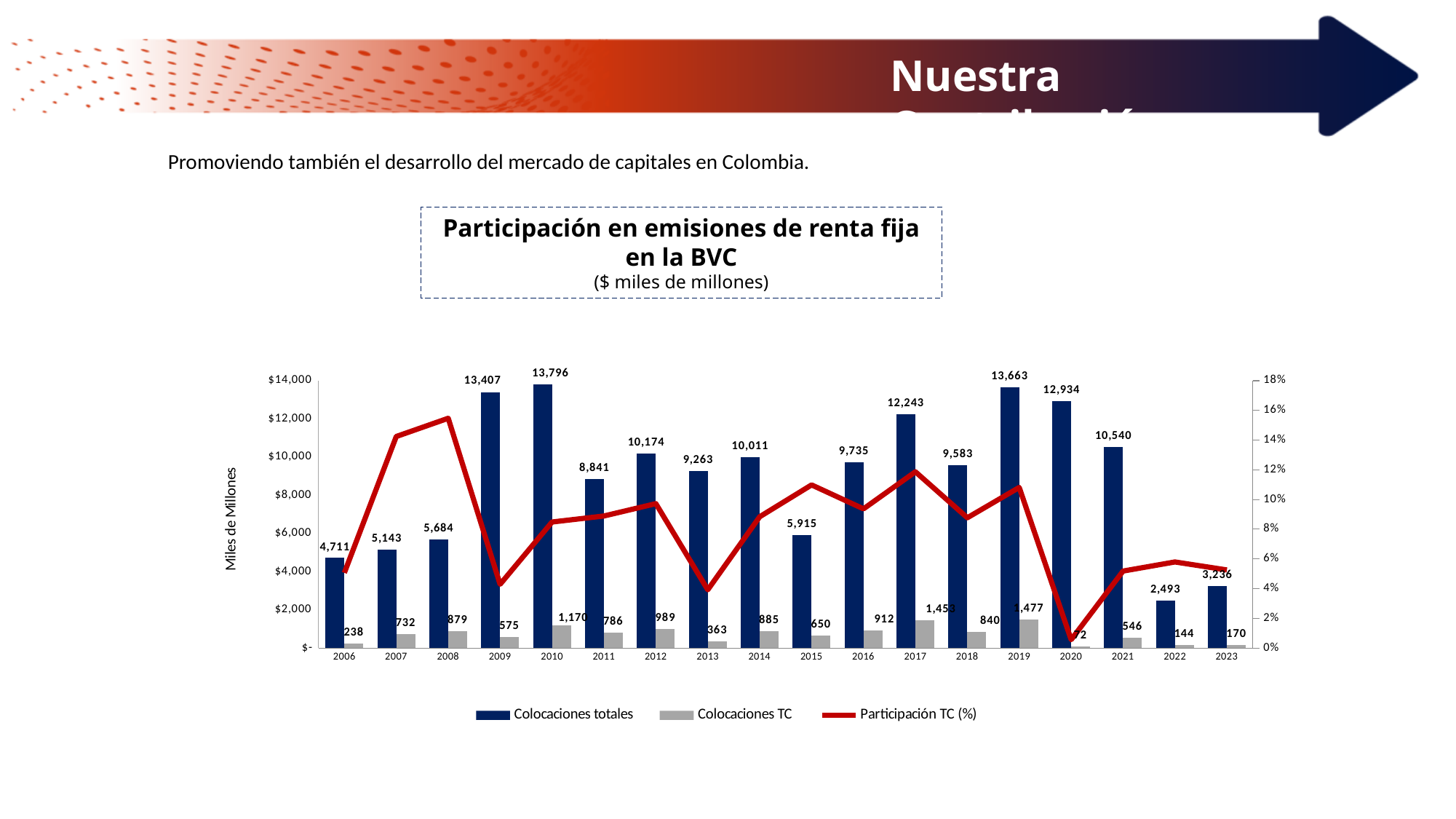
Which year has the highest Colocaciones TC? 2019 Which year has the lowest Colocaciones totales? 2022 What is the value of Colocaciones totales for 2022? 2,493 Which is larger, Colocaciones totales in 2017 or in 2020? 2020 How many years are shown on the x axis? 18 Which year has the highest Colocaciones totales? 2010 What kind of chart is shown on the slide? Combined bar and line chart How many series does the legend list? 3 What is the difference between Colocaciones totales in 2010 and 2019? 133 Is the Participación TC (%) value for 2008 greater or less than 14%? greater What is the value of Colocaciones TC for 2017? 1,453 What is the value of Colocaciones totales for 2010? 13,796